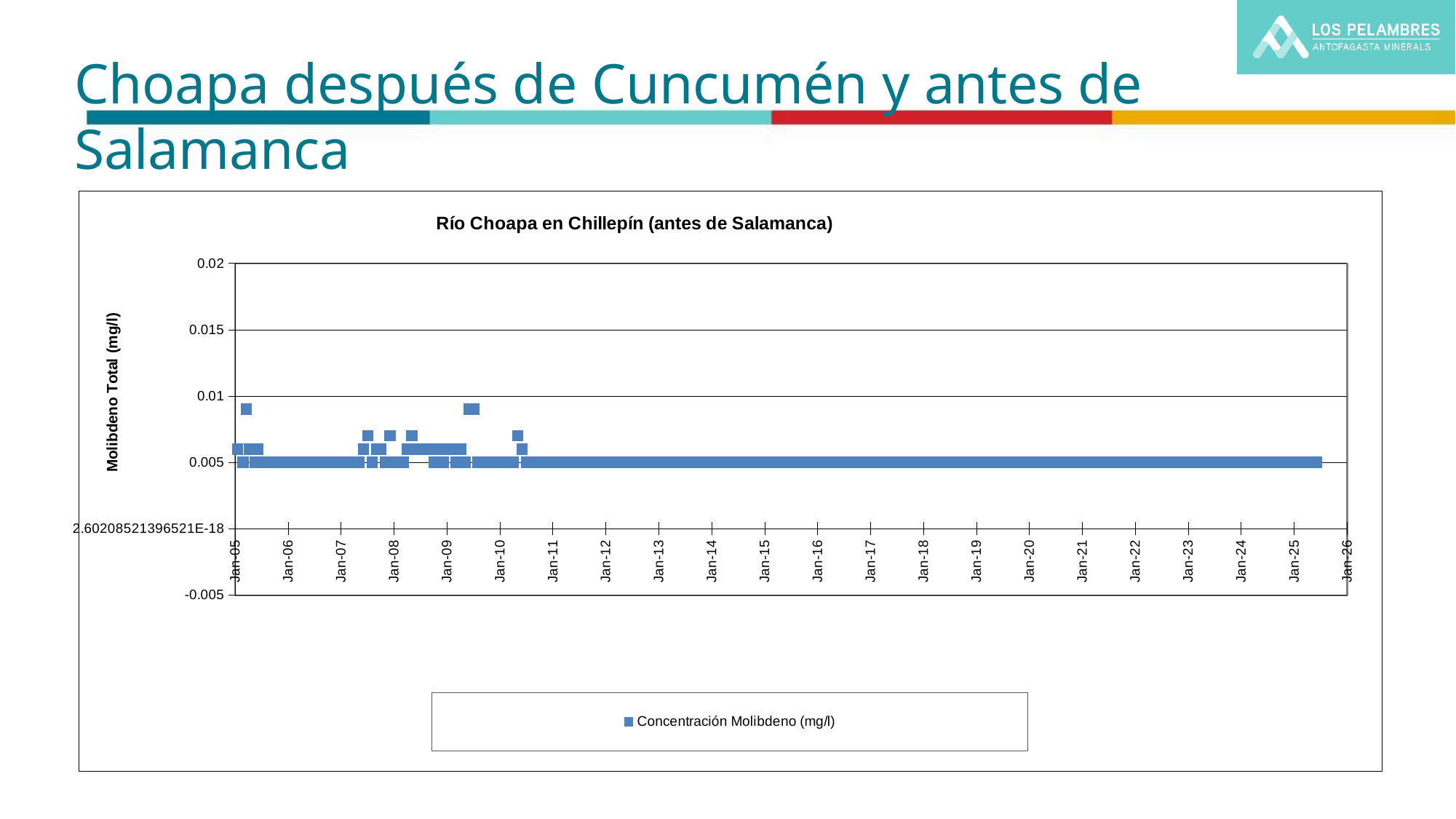
What is the title of the chart? Río Choapa en Chillepín (antes de Salamanca) What is the last year label on the x axis? Jan-26 Is the value plotted around Jan-15 greater or less than 0.01? less What value do most of the plotted points sit at on the y axis? 0.005 Is the highest plotted value greater or less than 0.01? less What kind of chart is shown on the slide? scatter chart From Jan-11 onward, do the plotted values rise, fall, or stay flat? stay flat What is the label of the y axis? Molibdeno Total (mg/l) What is the first year label on the x axis? Jan-05 Are the plotted values greater or less than 0.015? less How many series does the chart legend list? 1 What is the name of the series shown in the legend? Concentración Molibdeno (mg/l)